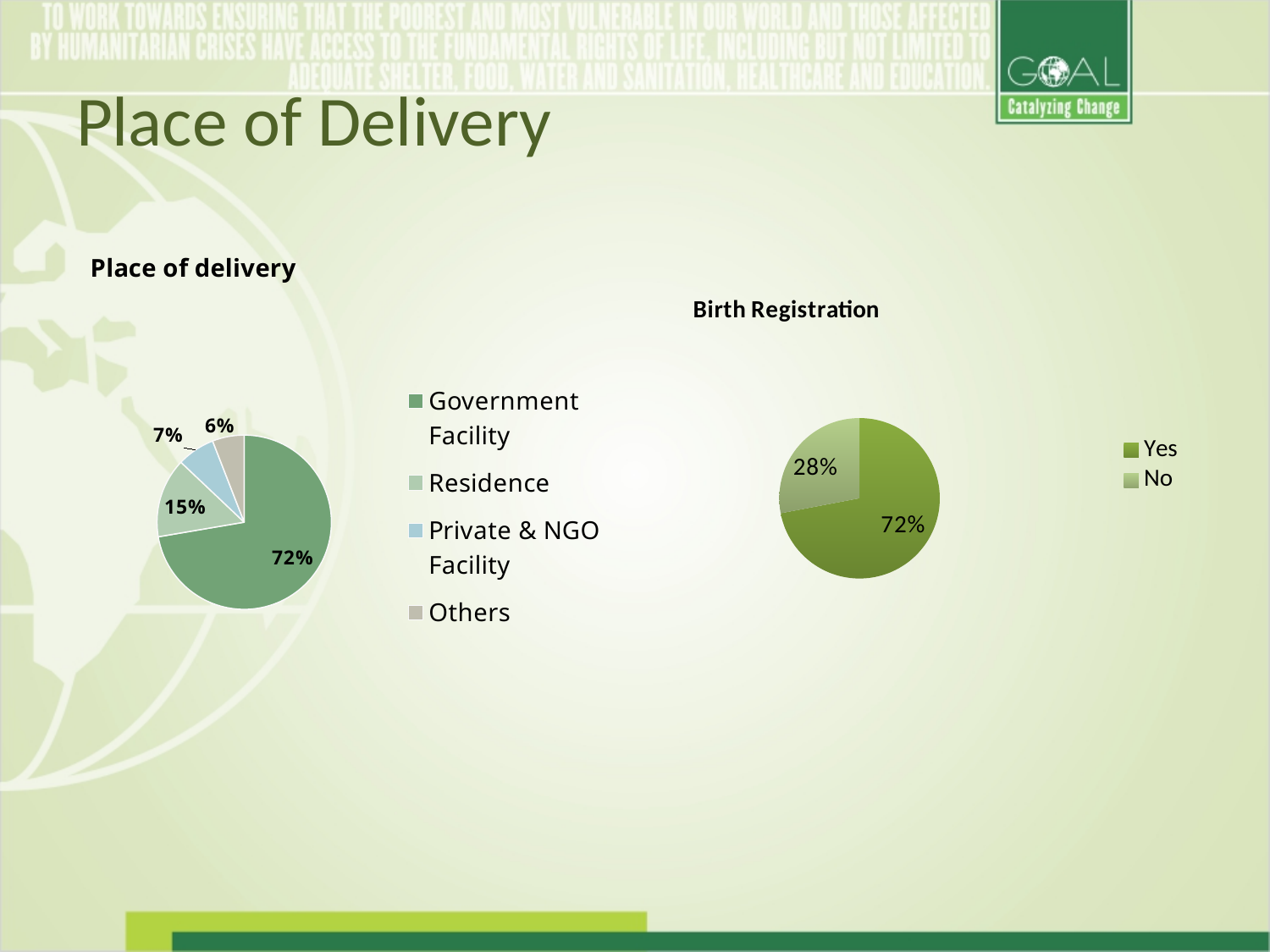
In the 'Place of delivery' chart, what percentage is shown for Others? 6% In the 'Place of delivery' chart, what is the difference in percentage points between Government Facility and Residence? 57 In the 'Place of delivery' chart, what percentage is shown for Residence? 15% In the 'Place of delivery' chart, which category has the smallest share? Others In the 'Birth Registration' chart, which is larger, Yes or No? Yes In the 'Place of delivery' chart, what share of deliveries took place in a Government Facility? 72% In the 'Place of delivery' chart, how many categories does the legend list? 4 In the 'Birth Registration' chart, what percentage answered Yes? 72% In the 'Place of delivery' chart, what percentage is shown for Private & NGO Facility? 7% What type of chart is the 'Birth Registration' chart? Pie chart In the 'Birth Registration' chart, what percentage answered No? 28% In the 'Place of delivery' chart, which category has the largest share? Government Facility